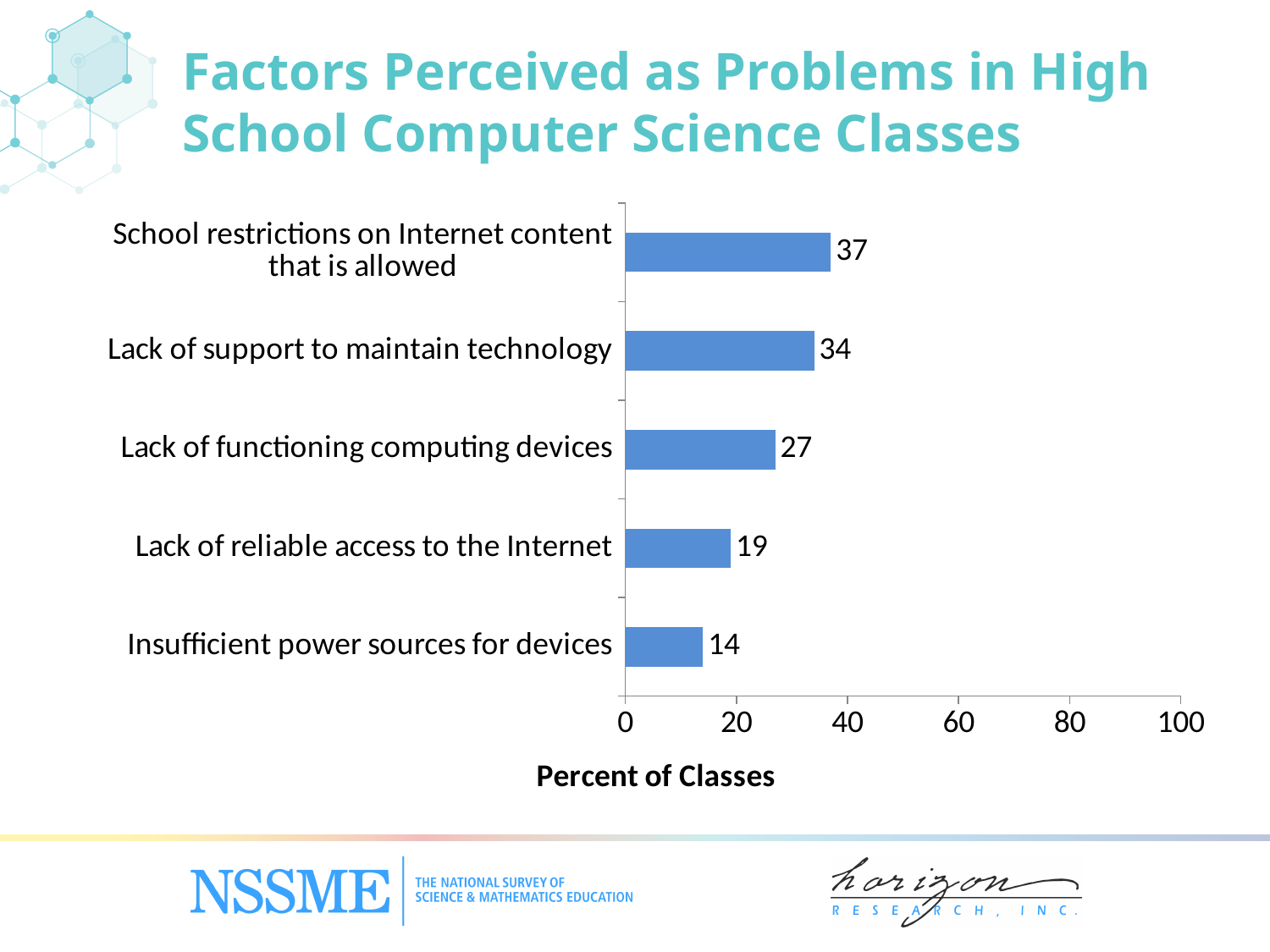
Which factor has the highest percent of classes? School restrictions on Internet content that is allowed What is the value for lack of support to maintain technology? 34 Which factor has the lowest percent of classes? Insufficient power sources for devices What is the value for lack of functioning computing devices? 27 What is the difference between the values for lack of support to maintain technology and lack of reliable access to the Internet? 15 What is the value for insufficient power sources for devices? 14 Is the value for lack of support to maintain technology greater or less than 40? less Which is larger: the value for lack of functioning computing devices or the value for lack of reliable access to the Internet? Lack of functioning computing devices What percent of classes reported school restrictions on Internet content that is allowed as a problem? 37 How many factors are shown in the chart? 5 What is the label of the horizontal axis? Percent of Classes What kind of chart is shown on the slide? Bar chart